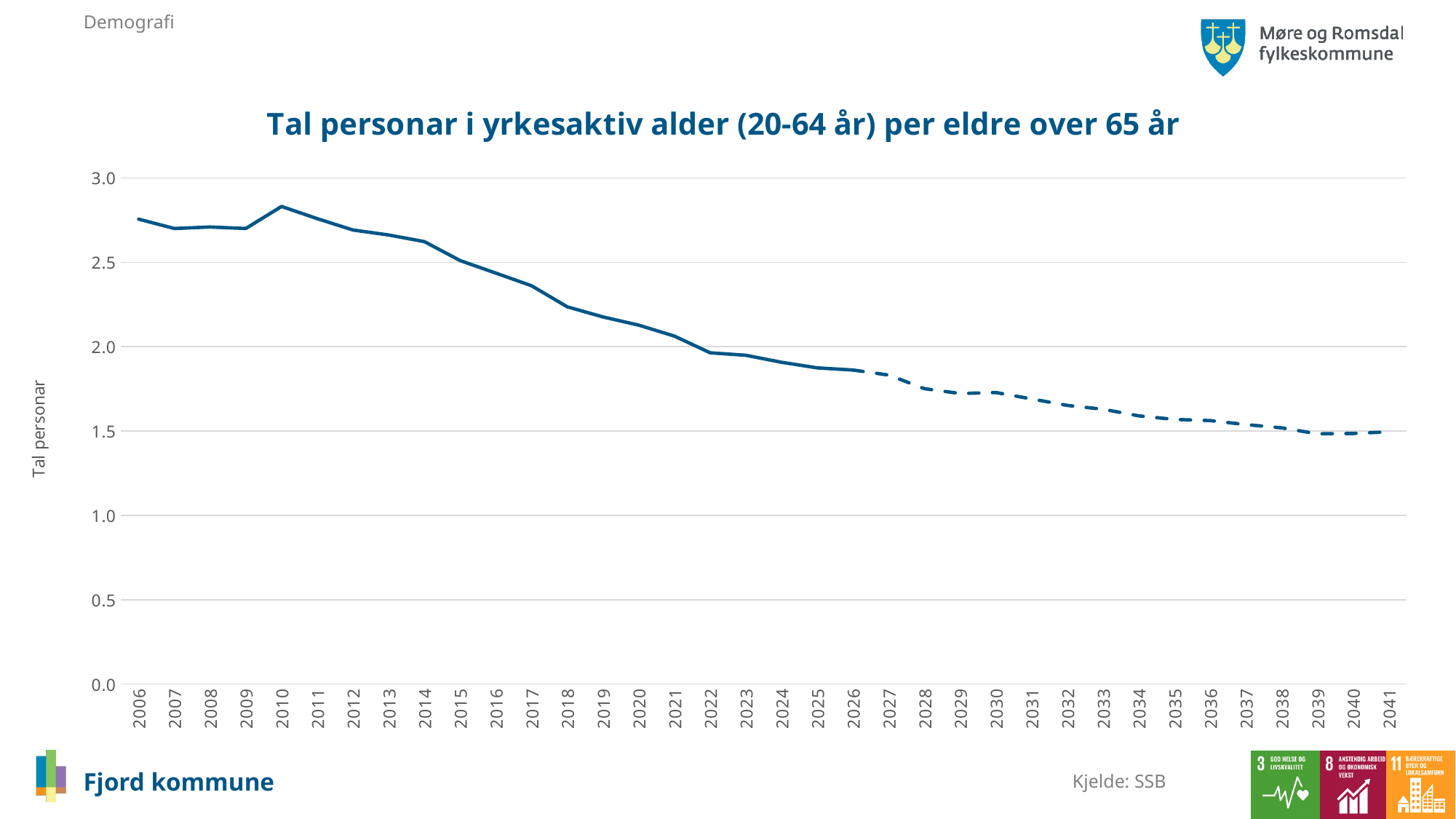
Is the value for 2006 greater or less than 2.5? greater How many years are shown along the x axis? 36 What is the label on the vertical axis? Tal personar What kind of chart is shown on the slide? line chart Do the values generally rise or fall from 2006 to 2041? fall Is the value for 2030 greater or less than 1.5? greater Is the value for 2022 greater or less than 2.0? less In which year is the value highest? 2010 What is the title of the chart? Tal personar i yrkesaktiv alder (20-64 år) per eldre over 65 år Which year has the larger value, 2010 or 2020? 2010